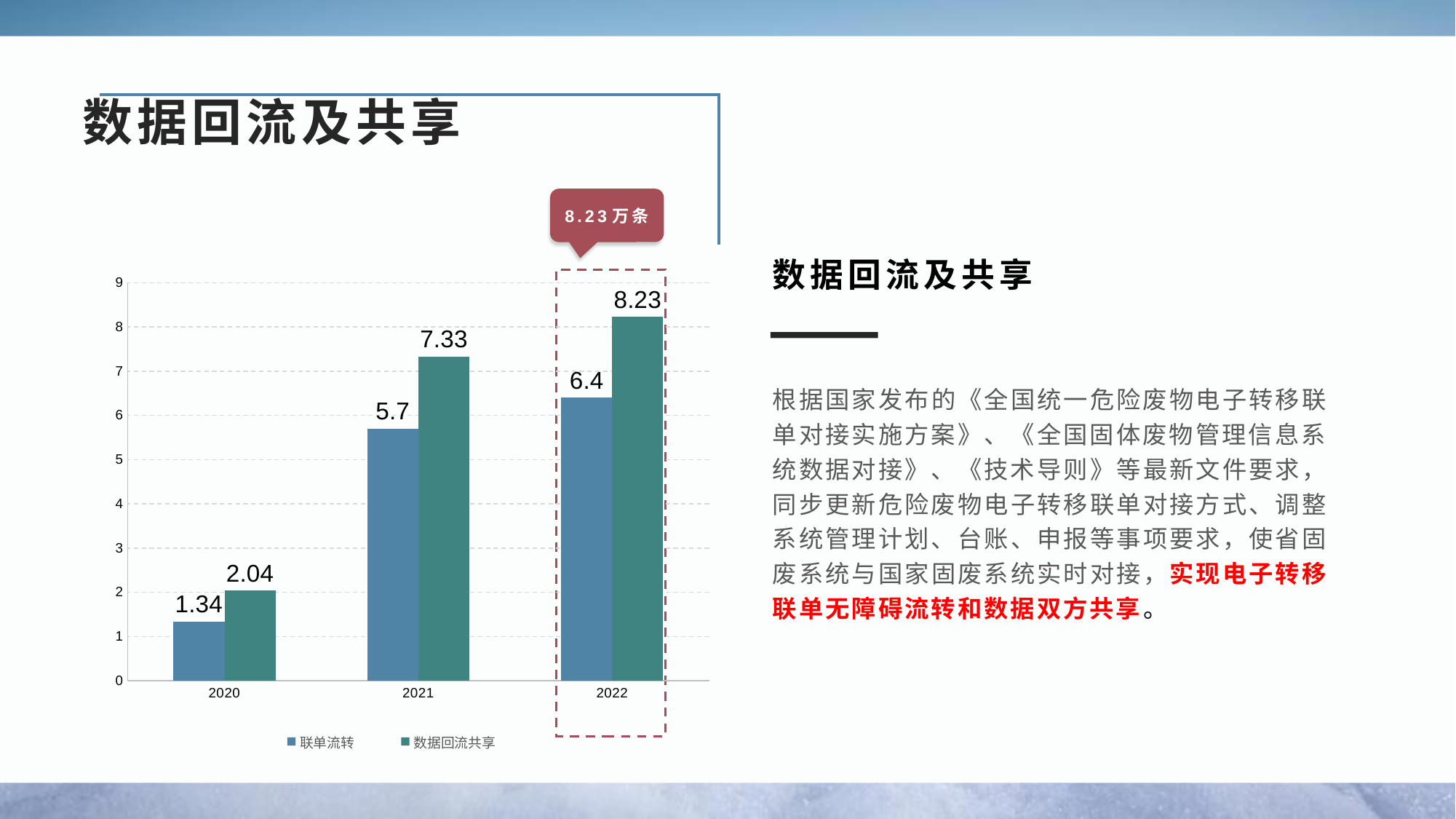
What is the value of 联单流转 for 2022? 6.4 Which year has the highest value for 数据回流共享? 2022 How many years are shown on the x axis? 3 What is the value of 联单流转 for 2020? 1.34 Do the values for 联单流转 rise or fall from 2020 to 2022? Rise What is the value of 数据回流共享 for 2022? 8.23 How many series does the legend list? 2 In 2021, which is larger: 联单流转 or 数据回流共享? 数据回流共享 What is the value of 数据回流共享 for 2021? 7.33 Which year has the lowest value for 联单流转? 2020 What is the difference between 数据回流共享 and 联单流转 in 2022? 1.83 What kind of chart is shown on the slide? Bar chart